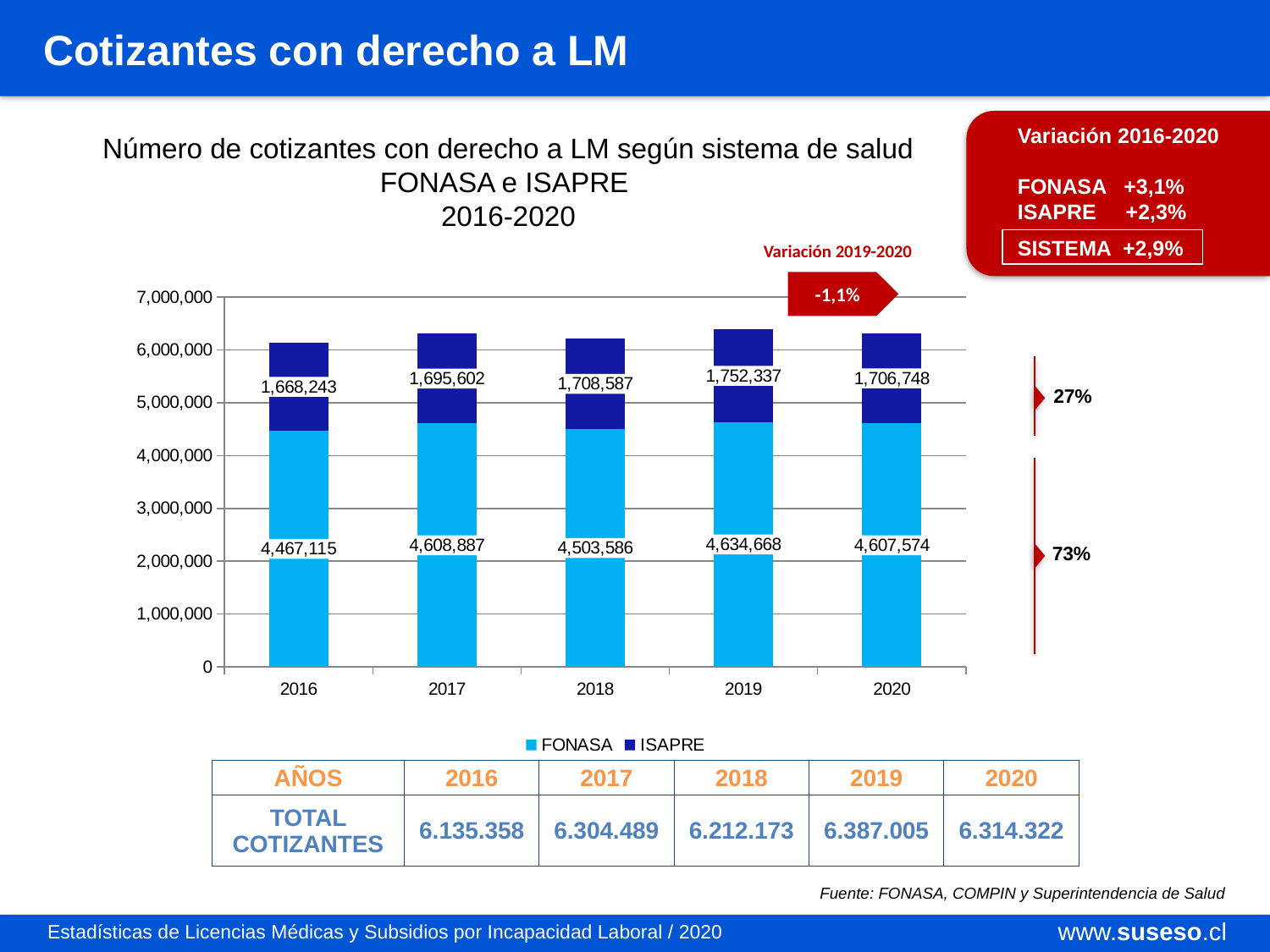
How many years are shown on the x axis of the chart? 5 What is the total of the 2016 stacked bar (FONASA plus ISAPRE)? 6,135,358 What is the difference between the FONASA values for 2019 and 2016? 167,553 What kind of chart is shown on the slide? Stacked bar chart What is the ISAPRE value for 2020? 1,706,748 By how much did the ISAPRE value fall from 2019 to 2020? 45,589 How many series does the chart legend list? 2 What is the FONASA value for 2018? 4,503,586 In which year is the ISAPRE value lowest? 2016 In which year is the FONASA value highest? 2019 Is the total height of the 2019 stacked bar greater or less than 6,000,000? greater Which is larger, the FONASA value for 2017 or for 2018? 2017